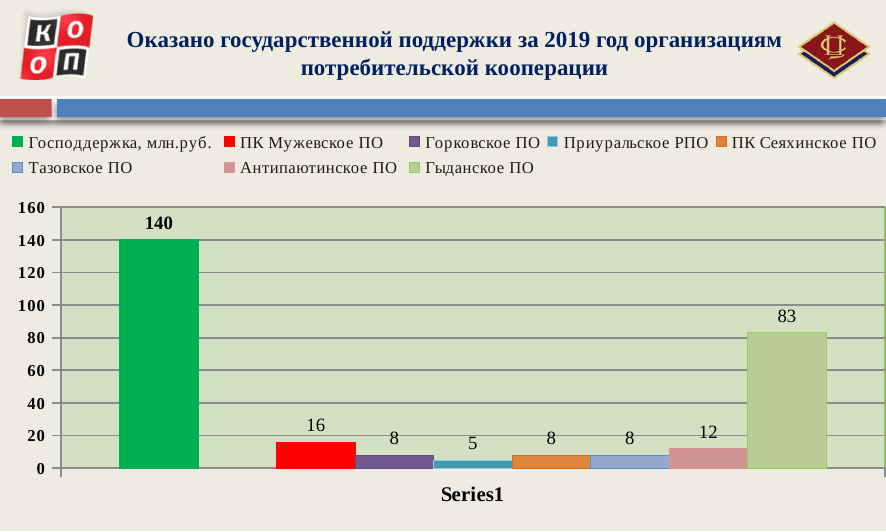
What is the value for Гыданское ПО? 83 What kind of chart is shown on the slide? Bar chart What is the value for ПК Мужевское ПО? 16 What is the difference between the values for Господдержка, млн.руб. and Гыданское ПО? 57 Which series has the lowest value? Приуральское РПО Which series has the highest value? Господдержка, млн.руб. Which is larger, the value for ПК Мужевское ПО or the value for Антипаютинское ПО? ПК Мужевское ПО What is the value for Господдержка, млн.руб.? 140 How many series does the legend list? 8 What is the value for Приуральское РПО? 5 What is the value for Антипаютинское ПО? 12 What colour is the bar for Гыданское ПО? Light green